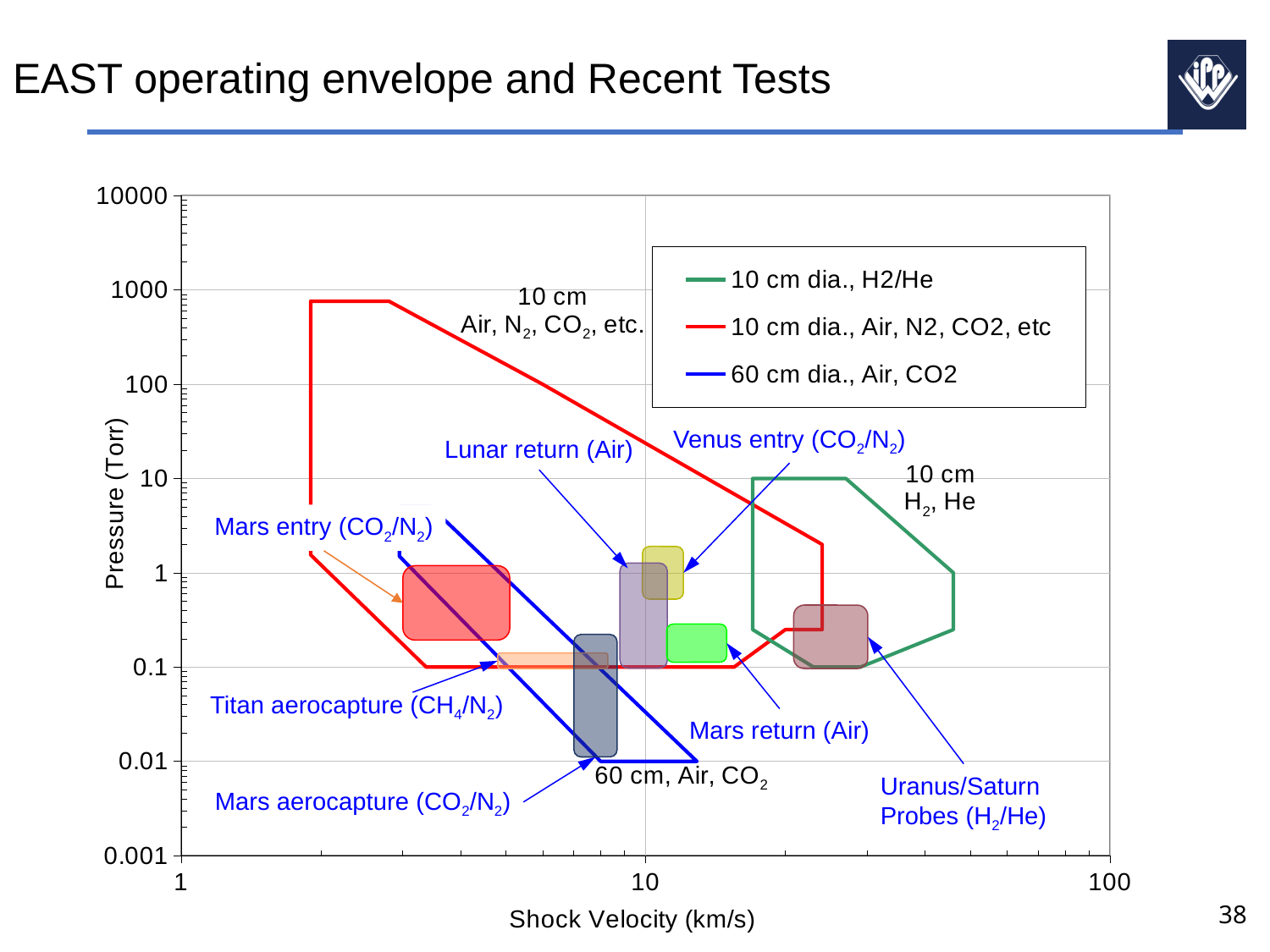
How many series does the legend list? 3 Which legend entry is drawn in green? 10 cm dia., H2/He Which operating envelope reaches the highest pressure? 10 cm dia., Air, N2, CO2, etc Is the minimum pressure of the 60 cm dia., Air, CO2 envelope greater or less than 0.1 Torr? less How many labelled mission test regions (e.g. Mars entry, Lunar return) are annotated on the chart? 7 What is the label of the x axis? Shock Velocity (km/s) Is the maximum pressure of the 10 cm dia., H2/He envelope greater or less than 100 Torr? less What is the label of the y axis? Pressure (Torr) Is the maximum pressure of the 10 cm dia., Air, N2, CO2 envelope greater or less than 1000 Torr? less Which operating envelope extends to the lowest pressure? 60 cm dia., Air, CO2 Which legend entry is drawn in blue? 60 cm dia., Air, CO2 Which operating envelope extends to the highest shock velocity? 10 cm dia., H2/He